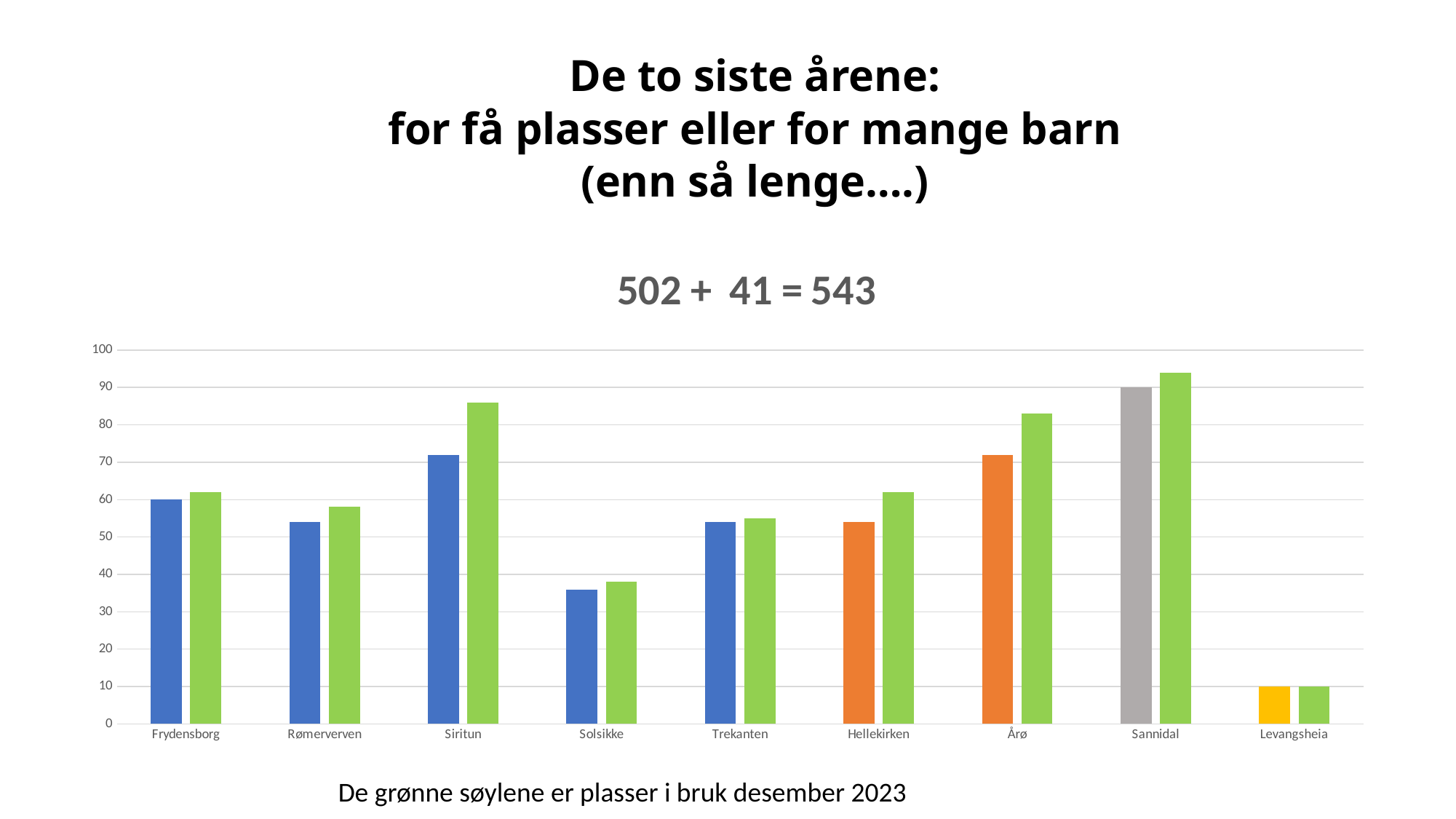
Is the value of the green bar for Siritun greater or less than 80? greater How many categories (barnehager) are shown along the x axis? 9 What kind of chart is shown on the slide? bar chart What is the value of the first (blue) bar for Frydensborg? 60 Is the value of the orange bar for Hellekirken greater or less than 50? greater What is the value of the grey bar for Sannidal? 90 Is the value of the green bar for Solsikke greater or less than 40? less Which category has the lowest green bar? Levangsheia Which green bar is taller, Siritun or Frydensborg? Siritun Which category has the highest green bar? Sannidal According to the text below the chart, what do the green bars represent? Plasser i bruk desember 2023 What is the value of the green bar for Levangsheia? 10